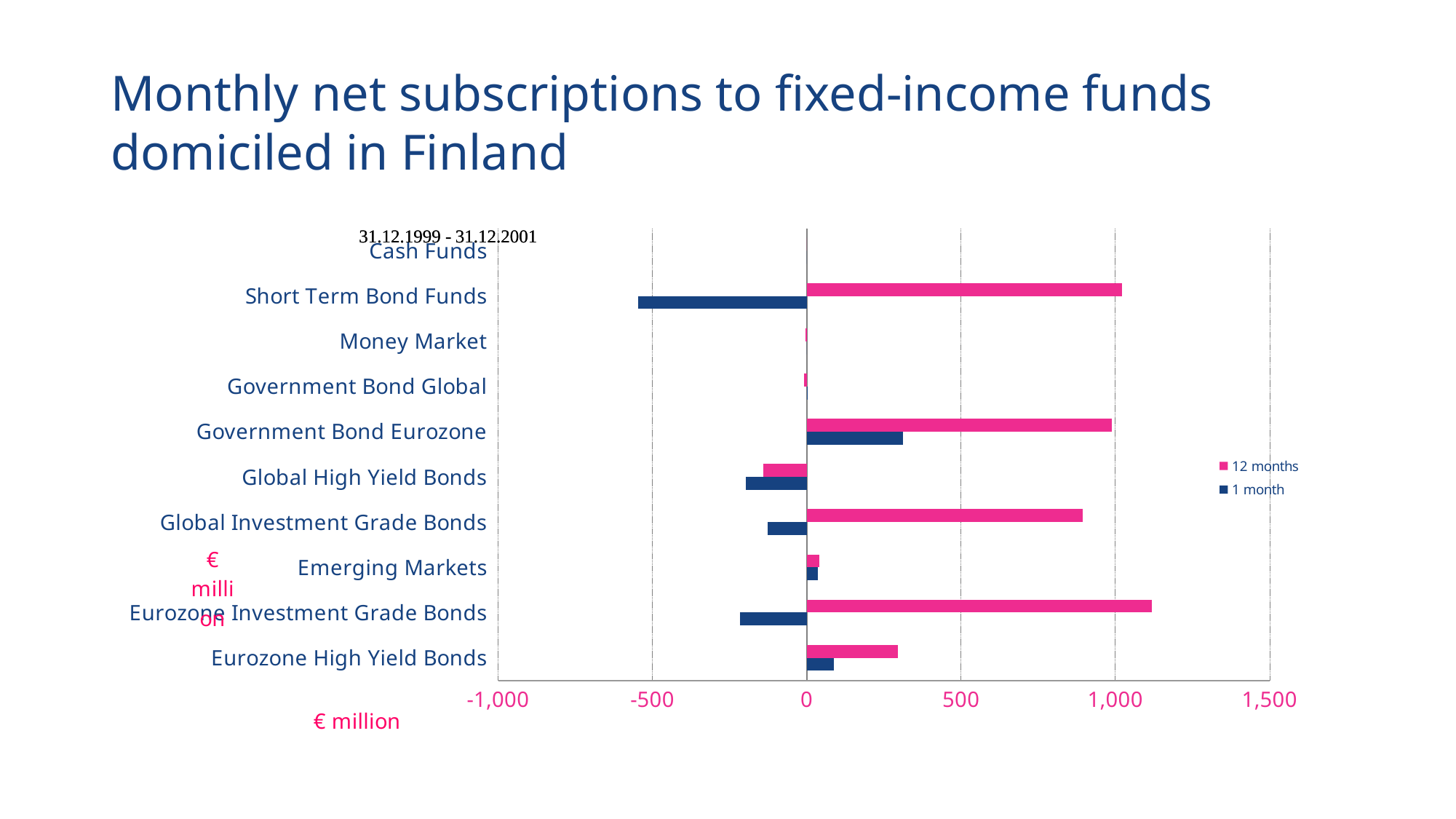
Is the 1 month value for Short Term Bond Funds greater or less than -500? less Which category has the lowest 1 month value? Short Term Bond Funds How many series does the legend list? 2 What kind of chart is shown on the slide? bar chart How many fund categories are listed on the vertical axis? 10 Is the 12 months value for Global Investment Grade Bonds greater or less than 1,000? less Is the 12 months value for Eurozone Investment Grade Bonds greater or less than 1,000? greater Which category has the highest 1 month value? Government Bond Eurozone Which is larger, the 12 months value for Government Bond Eurozone or the 12 months value for Global Investment Grade Bonds? Government Bond Eurozone What unit is shown on the horizontal axis label? € million Which category has the highest 12 months value? Eurozone Investment Grade Bonds